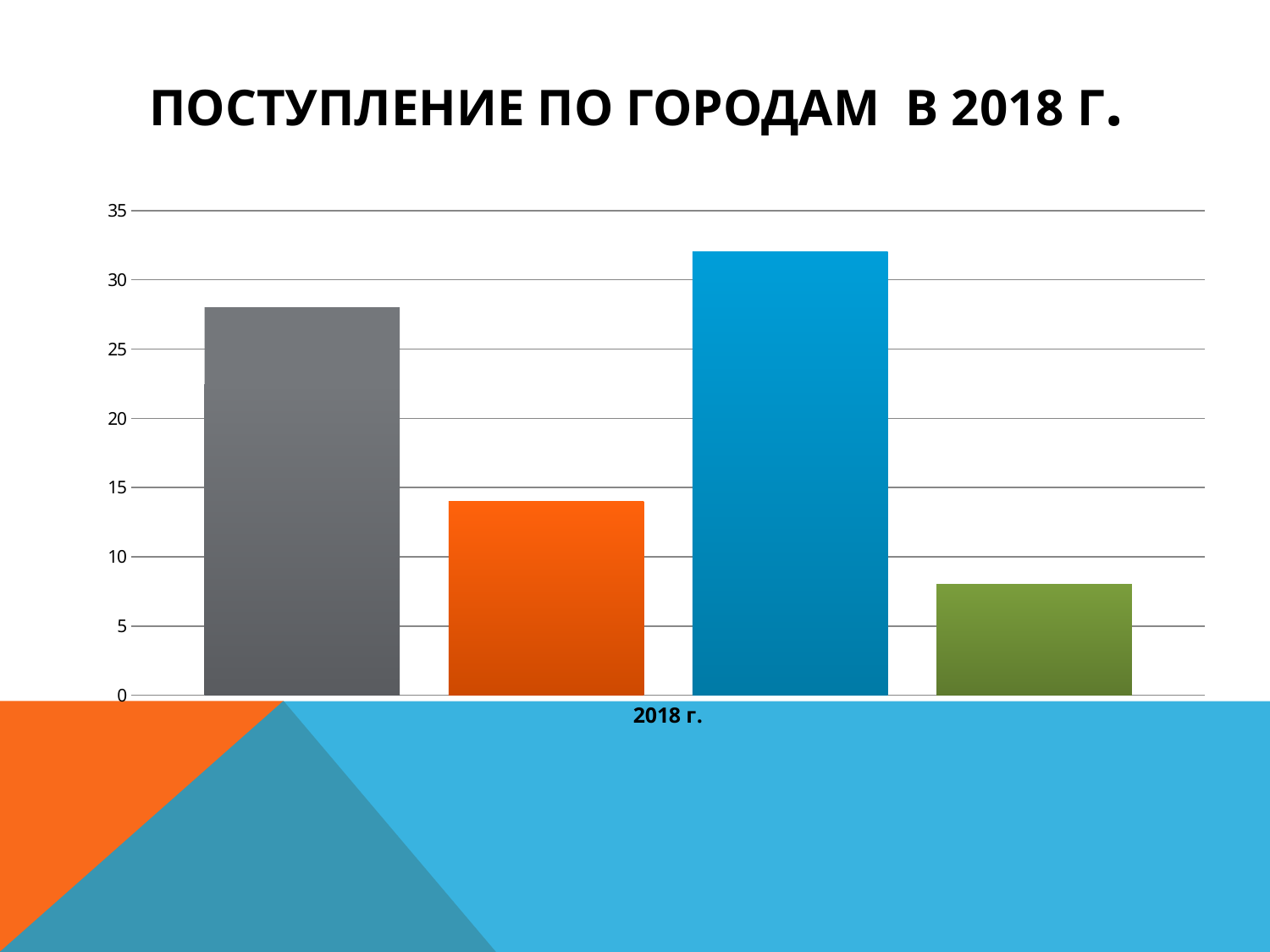
Which bar is the shortest in the chart? the green bar What kind of chart is shown on the slide? bar chart How many bars are plotted in the chart? 4 What label is shown on the horizontal axis of the chart? 2018 г. What is the title of the chart? ПОСТУПЛЕНИЕ ПО ГОРОДАМ В 2018 Г. Which is larger, the gray bar or the orange bar? the gray bar Is the value of the green bar greater or less than 10? less Is the value of the blue bar greater or less than 30? greater Which bar is the tallest in the chart? the blue bar Is the value of the orange bar greater or less than 15? less Which is larger, the orange bar or the green bar? the orange bar